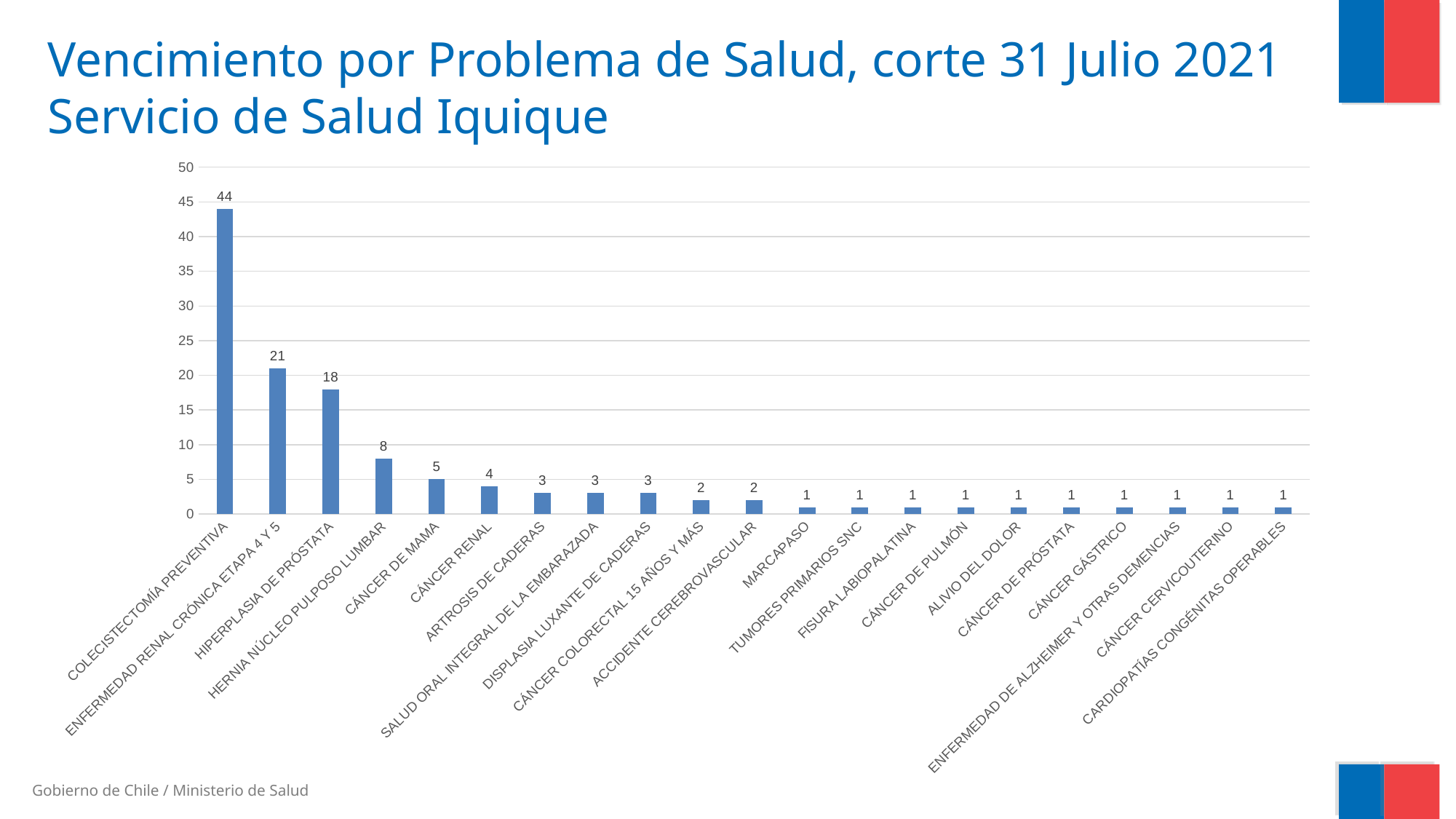
What is the difference between the values for COLECISTECTOMÍA PREVENTIVA and ENFERMEDAD RENAL CRÓNICA ETAPA 4 Y 5? 23 What kind of chart is shown on the slide? Bar chart What is the title of the slide? Vencimiento por Problema de Salud, corte 31 Julio 2021 Servicio de Salud Iquique What is the value for COLECISTECTOMÍA PREVENTIVA? 44 What is the difference between the values for HIPERPLASIA DE PRÓSTATA and HERNIA NÚCLEO PULPOSO LUMBAR? 10 Which is larger, the value for CÁNCER DE MAMA or the value for ACCIDENTE CEREBROVASCULAR? CÁNCER DE MAMA Which category has the highest value? COLECISTECTOMÍA PREVENTIVA What is the value for CÁNCER RENAL? 4 Do the values rise or fall from left to right along the x axis? Fall How many categories are shown on the x axis? 21 What is the value for HIPERPLASIA DE PRÓSTATA? 18 What is the value for HERNIA NÚCLEO PULPOSO LUMBAR? 8